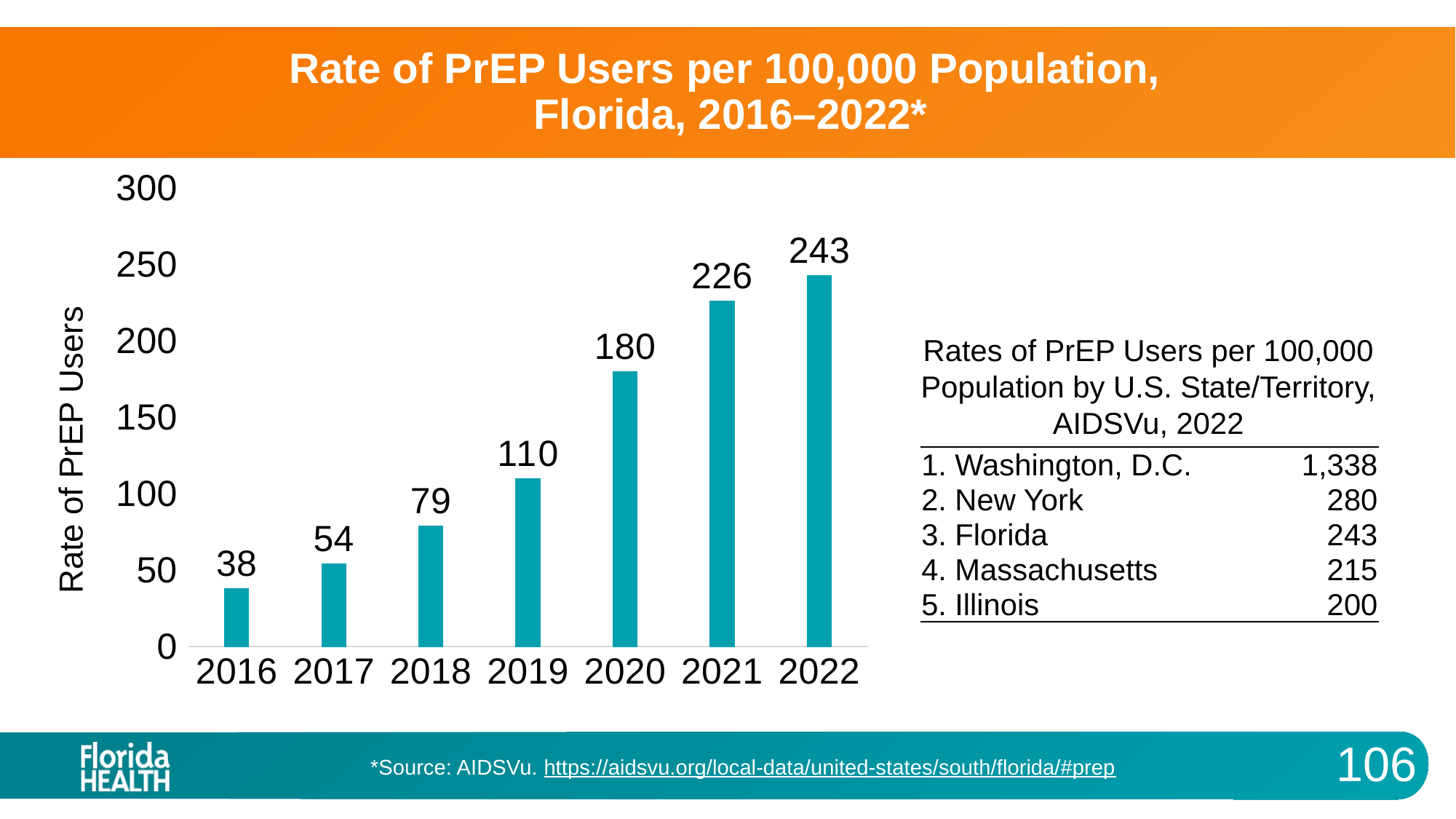
What is the rate of PrEP users per 100,000 population in Florida in 2016? 38 Which year has a higher rate of PrEP users, 2018 or 2019? 2019 Which year has the highest rate of PrEP users in the chart? 2022 What is the label of the y axis of the chart? Rate of PrEP Users What is the difference between the rate of PrEP users in 2022 and in 2021? 17 Which year has the lowest rate of PrEP users in the chart? 2016 Do the rates of PrEP users rise or fall from 2016 to 2022? Rise What kind of chart is shown on the slide? Bar chart What is the difference between the rate of PrEP users in 2020 and in 2019? 70 What is the rate of PrEP users per 100,000 population in Florida in 2020? 180 What is the rate of PrEP users per 100,000 population in Florida in 2022? 243 How many years are shown on the x axis of the chart? 7